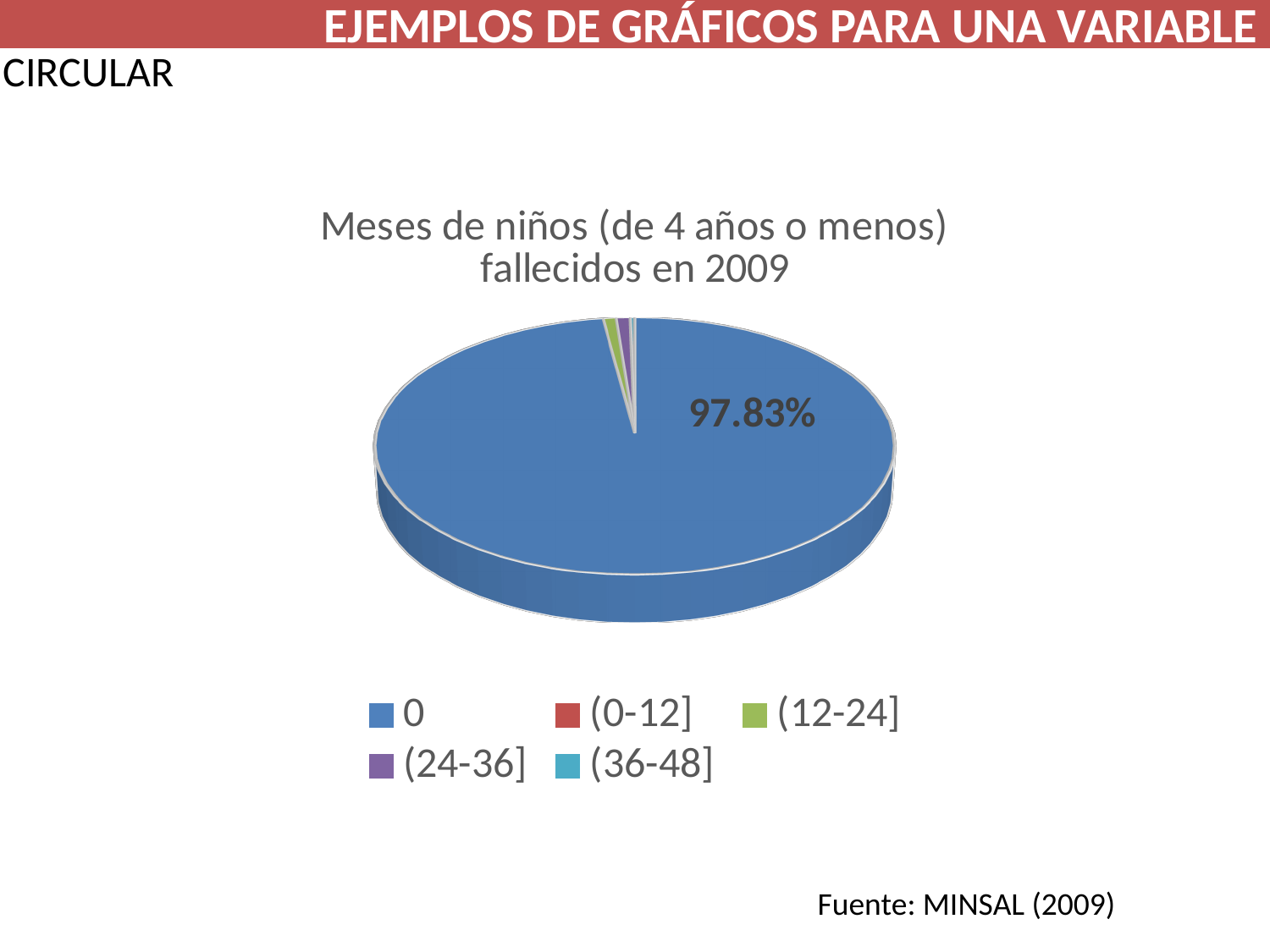
How many categories does the legend of the pie chart list? 5 Which category has the largest slice in the pie chart? 0 Which slice is larger in the pie chart, "0" or "(24-36]"? 0 What source is cited below the pie chart? Fuente: MINSAL (2009) What percentage is shown for the "0" slice of the pie chart? 97.83% What share of the pie does the "0" category represent? 97.83% What is the title of the pie chart? Meses de niños (de 4 años o menos) fallecidos en 2009 Which slice is larger in the pie chart, "0" or "(12-24]"? 0 What kind of chart is shown on the slide? Pie chart